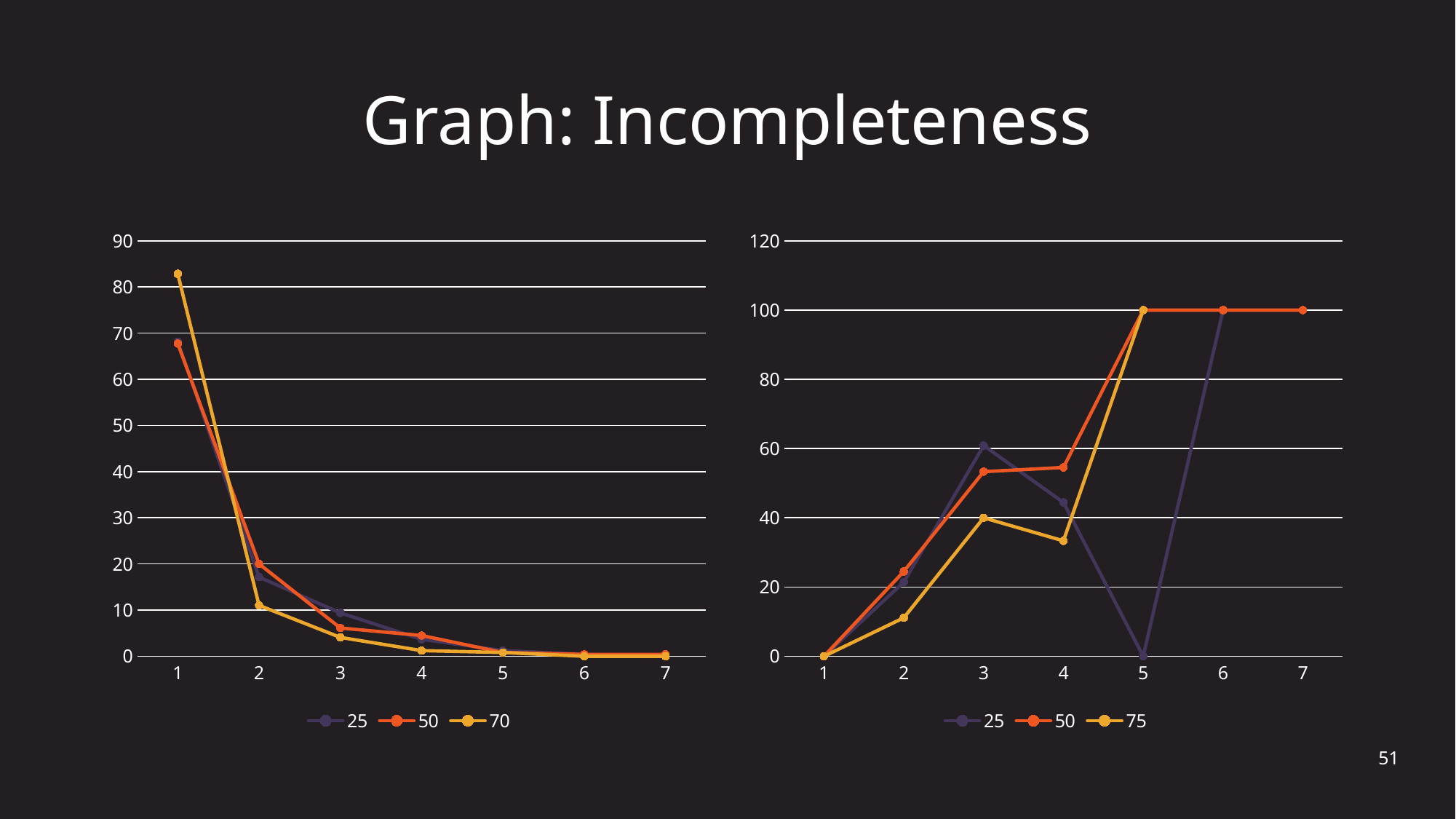
In the left chart, is the value of the 70 series at x=2 greater or less than 20? less What kind of chart is the left chart on the slide? line chart How many series does the legend of the right chart list? 3 How many x-axis categories does the right chart have? 7 In the right chart, what is the value of the 50 series at x=7? 100 In the left chart, do the values of the 70 series rise or fall from x=1 to x=7? fall In the right chart, do the values of the 50 series rise or fall from x=1 to x=5? rise In the right chart, what is the value of the 25 series at x=5? 0 In the left chart, which series has the highest value at x=1? 70 In the left chart, is the value of the 50 series at x=1 greater or less than 60? greater In the right chart, which series has the lowest value at x=4? 75 What are the legend entries of the left chart? 25, 50, 70